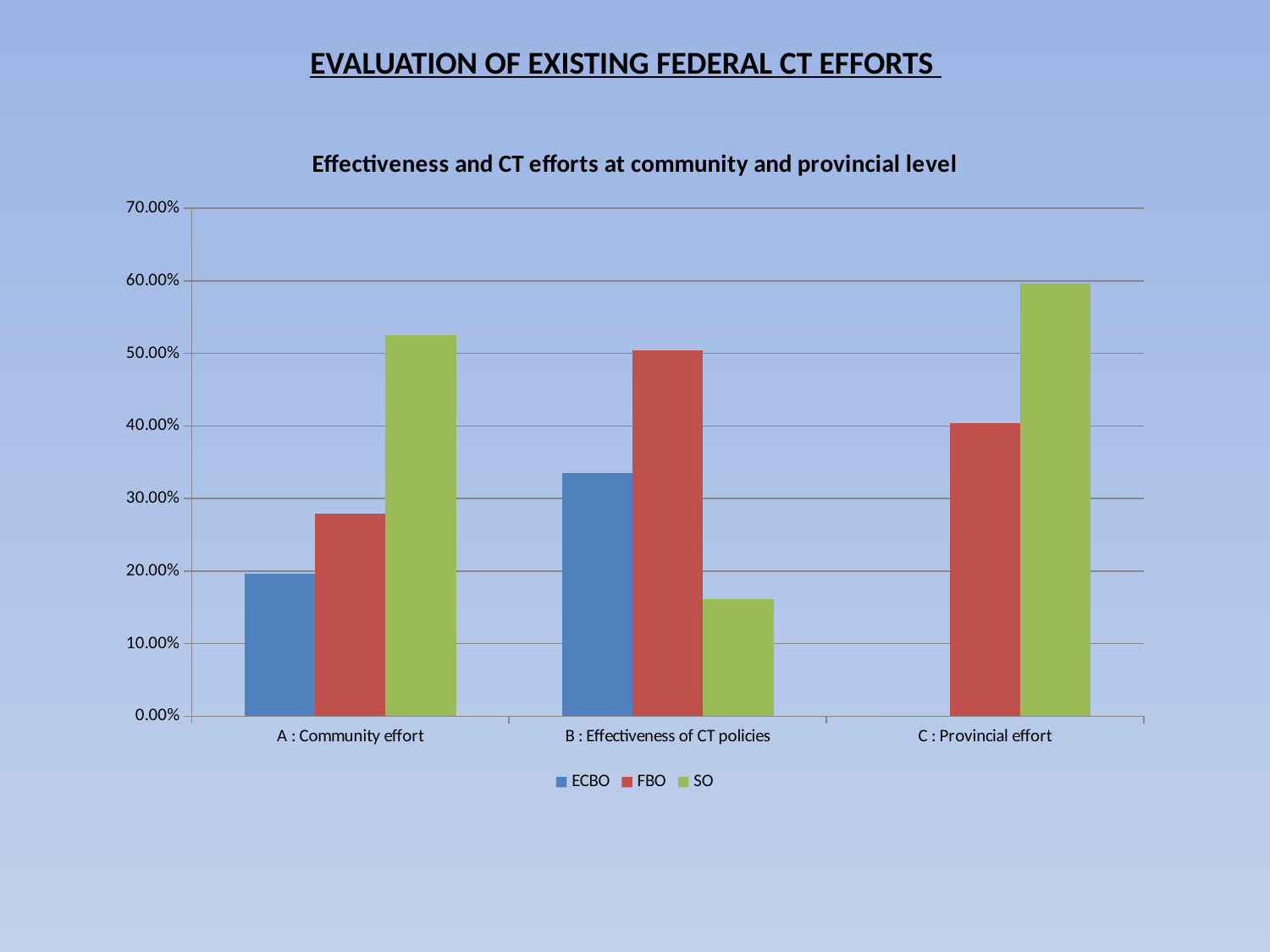
Is the value for SO in C : Provincial effort greater or less than 50.00%? greater Which series has the lowest value for B : Effectiveness of CT policies? SO Which is larger for B : Effectiveness of CT policies, ECBO or FBO? FBO How many categories are shown on the x axis? 3 Which series has the highest value for C : Provincial effort? SO What is the title of the chart? Effectiveness and CT efforts at community and provincial level What kind of chart is shown on the slide? Bar chart Is the value for SO in A : Community effort greater or less than 50.00%? greater How many series does the legend list? 3 Which series has the highest value for A : Community effort? SO Which category has the highest SO value? C : Provincial effort